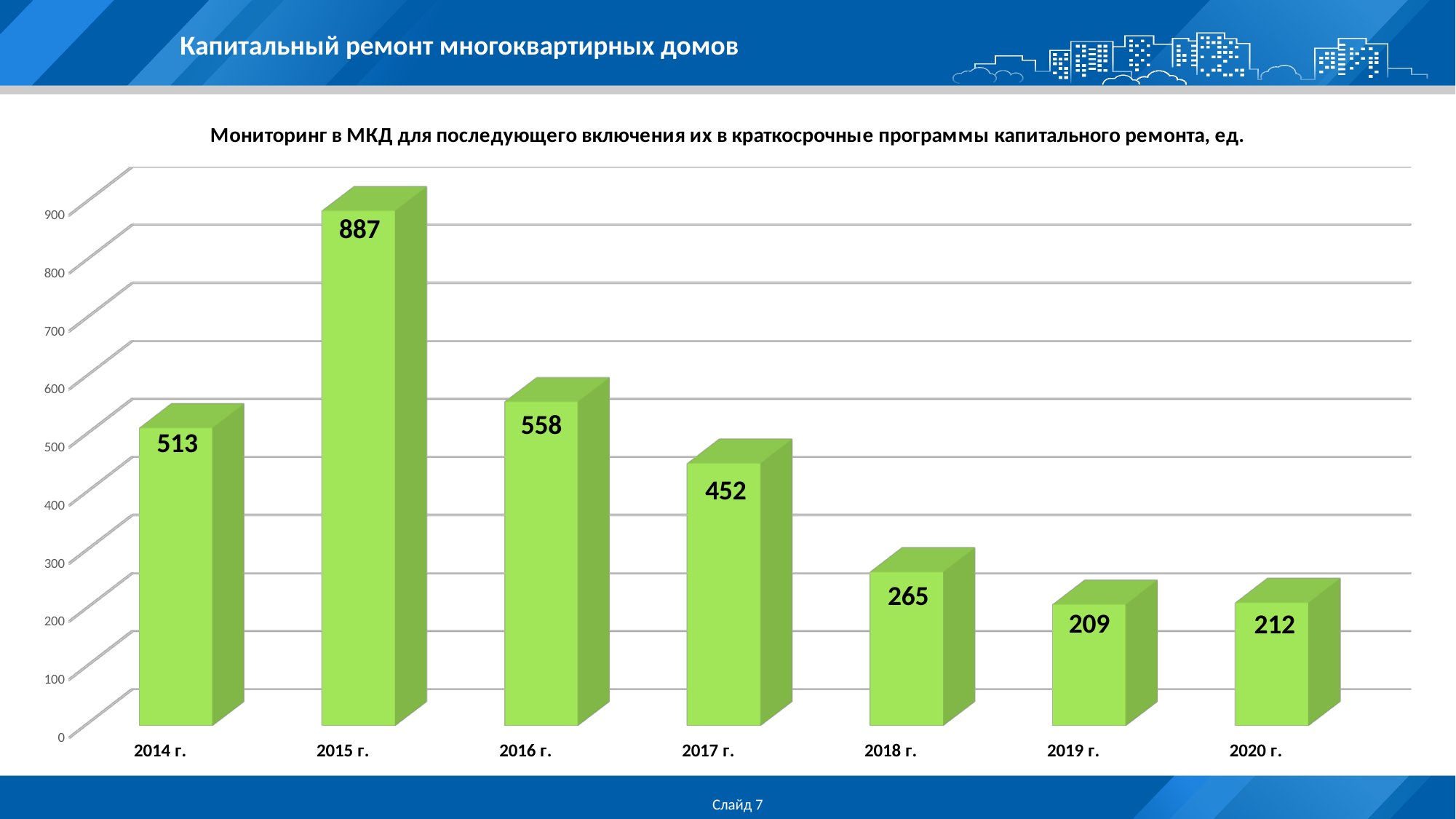
What is the difference between the values for 2015 г. and 2016 г.? 329 What is the value for 2020 г.? 212 How many years are shown on the x axis? 7 What is the title of the chart? Мониторинг в МКД для последующего включения их в краткосрочные программы капитального ремонта, ед. What is the value for 2015 г.? 887 What kind of chart is shown on the slide? bar chart What is the difference between the values for 2014 г. and 2017 г.? 61 Is the value for 2017 г. greater or less than 400? greater What is the value for 2018 г.? 265 Which is larger, the value for 2016 г. or the value for 2014 г.? 2016 г. Which year has the lowest value? 2019 г. Which year has the highest value? 2015 г.